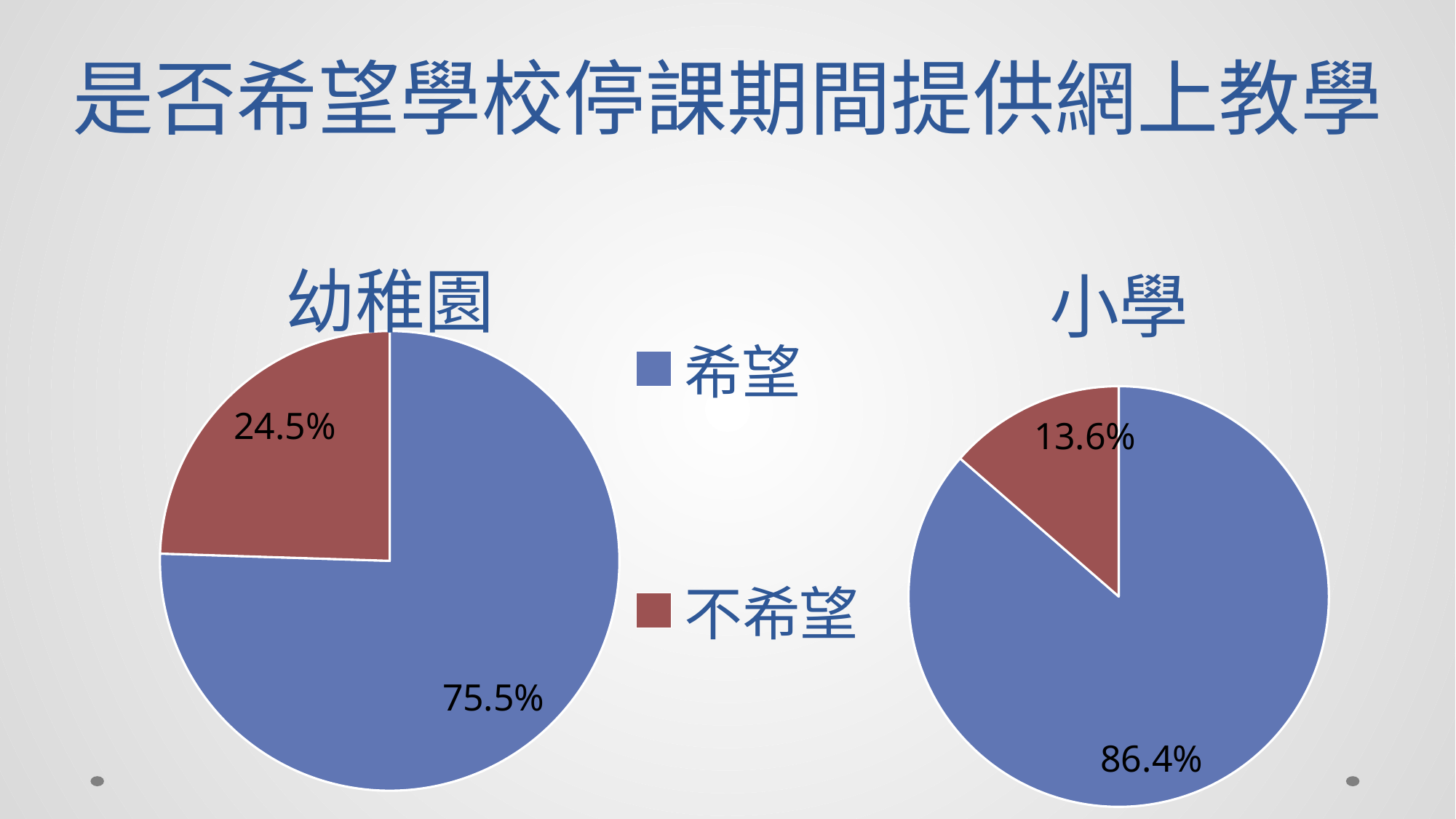
In the 小學 pie chart, what percentage is shown for 希望? 86.4% In the 小學 pie chart, what percentage is shown for 不希望? 13.6% Which is larger: the 不希望 share in the 幼稚園 chart or the 不希望 share in the 小學 chart? 幼稚園 In the 幼稚園 pie chart, which category has the largest slice? 希望 In the 小學 pie chart, which category has the smallest slice? 不希望 What type of chart is used for the 小學 data? Pie chart In the 幼稚園 pie chart, what percentage is shown for 希望? 75.5% What colour represents 不希望 in the pie charts? Red How many entries does the legend list? 2 In the 幼稚園 pie chart, what percentage is shown for 不希望? 24.5% How many slices does the 幼稚園 pie chart have? 2 In the 幼稚園 pie chart, what is the difference between the 希望 and 不希望 percentages? 51.0%